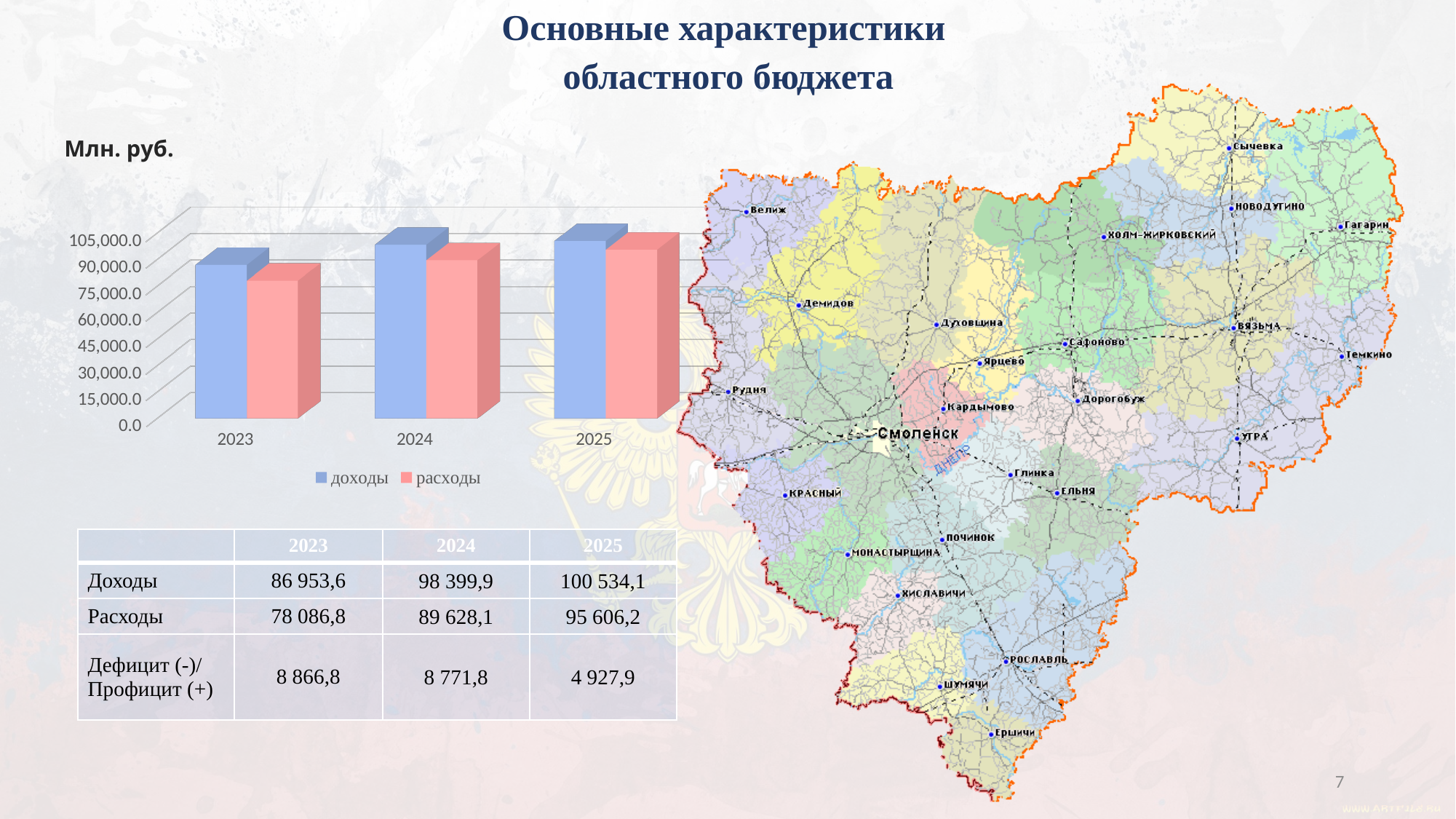
How many years are shown on the x axis of the chart? 3 What kind of chart is shown on the slide? bar chart What are the two legend entries of the chart? доходы, расходы According to the table below the chart, what is the value of Доходы for 2024? 98 399,9 What unit label is shown above the chart? Млн. руб. According to the table below the chart, what is the difference between Доходы and Расходы in 2025? 4 927,9 Which year has the highest доходы bar? 2025 Do the доходы bars rise or fall from 2023 to 2025? rise How many series does the chart legend list? 2 In 2023, which is larger, доходы or расходы? доходы Is the расходы value for 2023 greater or less than 90,000.0? less Is the доходы value for 2025 greater or less than 90,000.0? greater